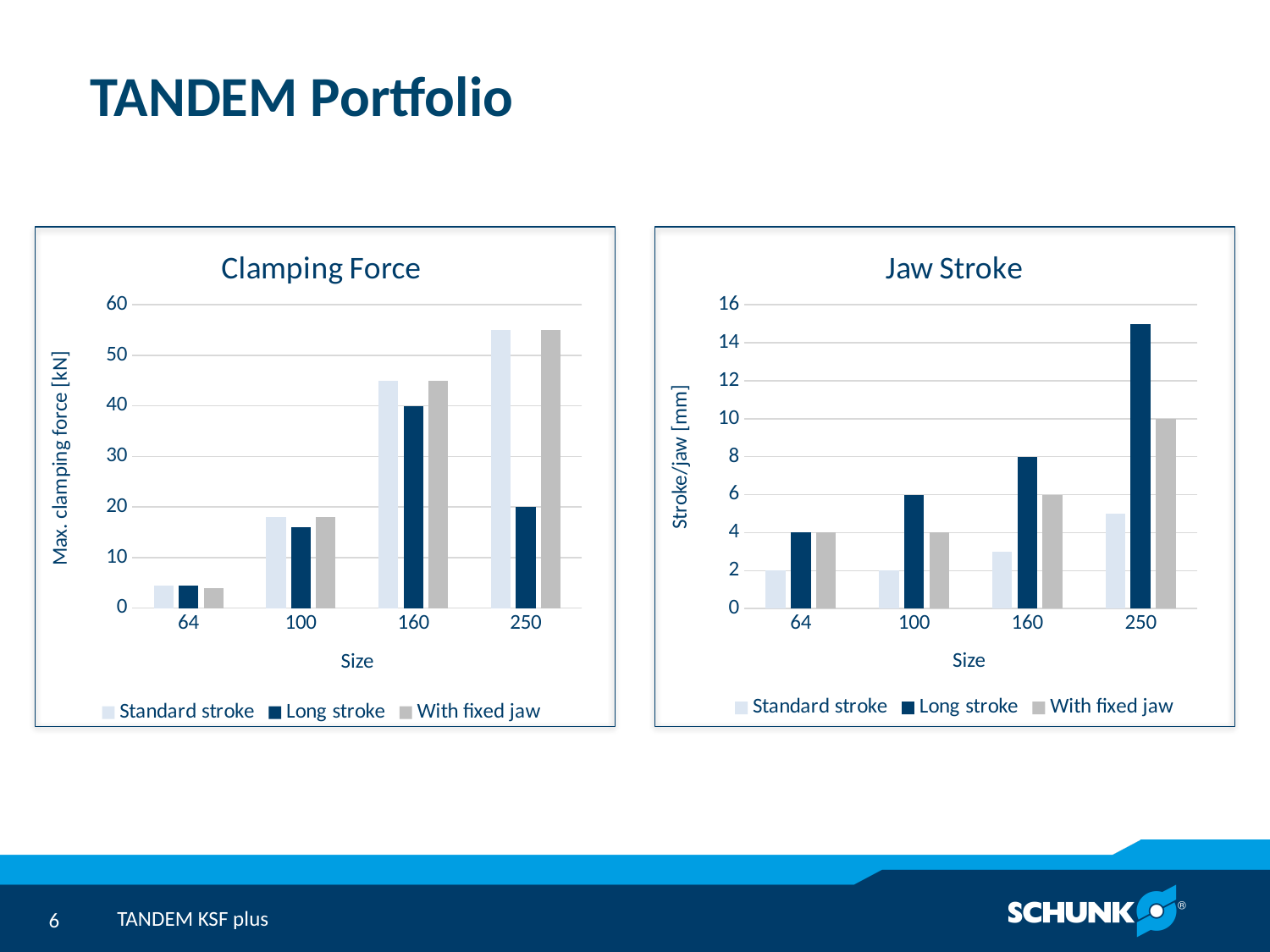
In the Jaw Stroke chart, what is the difference between the Long stroke and With fixed jaw values for size 100? 2 How many sizes are shown on the x axis of the Jaw Stroke chart? 4 What kind of chart is the Jaw Stroke chart? bar chart In the Clamping Force chart, what is the Long stroke value for size 160? 40 How many series does the legend of the Clamping Force chart list? 3 In the Jaw Stroke chart, what is the With fixed jaw value for size 250? 10 In the Jaw Stroke chart, what is the Long stroke value for size 160? 8 In the Jaw Stroke chart, which size has the highest Long stroke value? 250 In the Clamping Force chart, is the Standard stroke value for size 100 greater or less than 20? less In the Clamping Force chart, for size 250, which is larger: Standard stroke or Long stroke? Standard stroke In the Clamping Force chart, what is the Long stroke value for size 250? 20 In the Clamping Force chart, is the Standard stroke value for size 250 greater or less than 50? greater